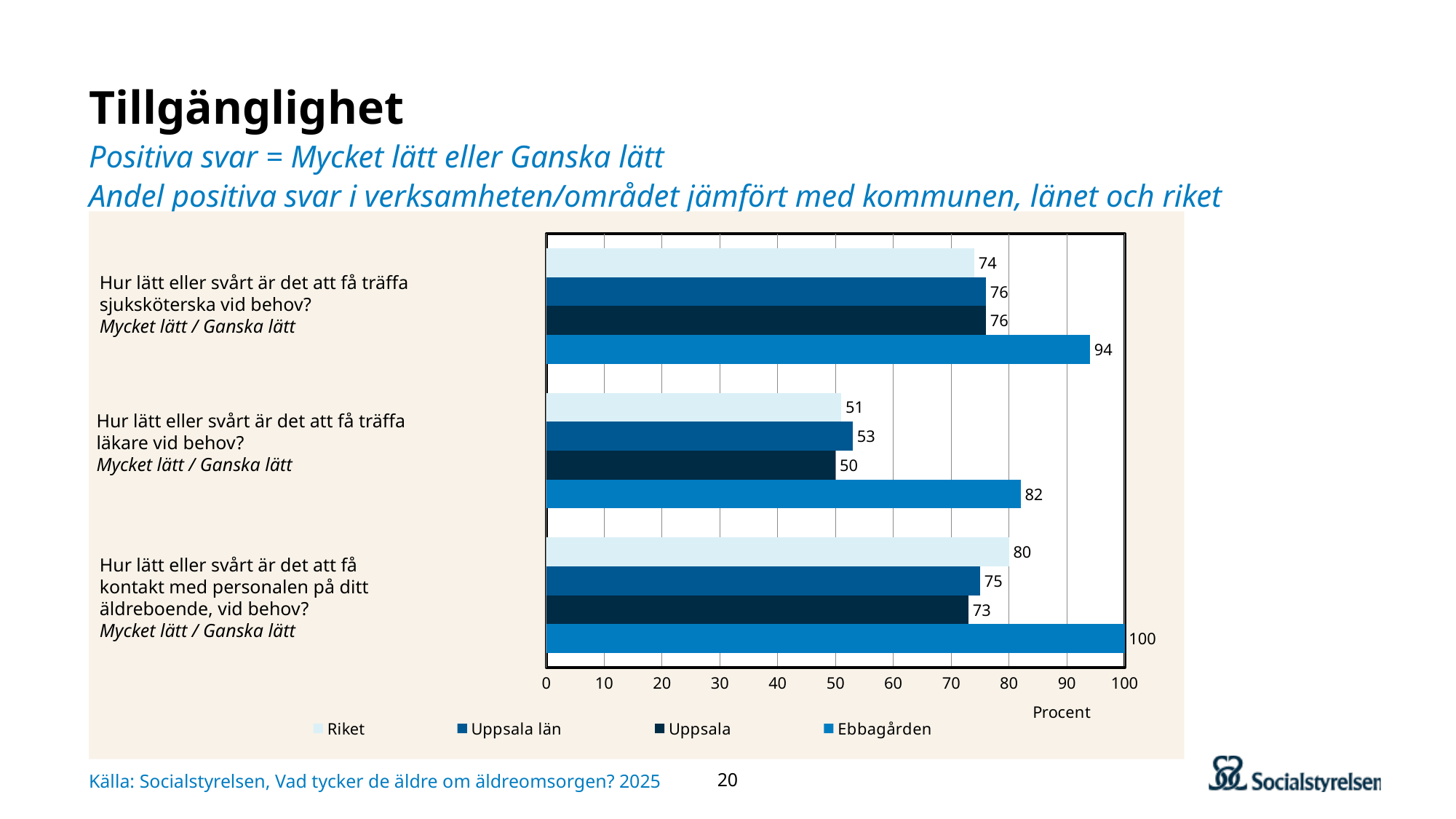
What unit is shown on the horizontal axis of the chart? Procent What is the value for Uppsala on the question about getting in contact with staff at the elderly home? 73 What is the value for Riket on the question about meeting a doctor (läkare) when needed? 51 What is the difference between Ebbagården and Riket on the question about meeting a doctor (läkare) when needed? 31 Which series has the highest value on the question about getting in contact with staff at the elderly home? Ebbagården How many question categories are shown on the chart? 3 What kind of chart is shown on the slide? Bar chart How many series does the legend list? 4 Which series has the lowest value on the question about meeting a doctor (läkare) when needed? Uppsala What is the difference between Ebbagården and Uppsala on the question about meeting a nurse (sjuksköterska) when needed? 18 What is the value for Ebbagården on the question about meeting a nurse (sjuksköterska) when needed? 94 On the question about getting in contact with staff, which is larger: Riket or Uppsala län? Riket